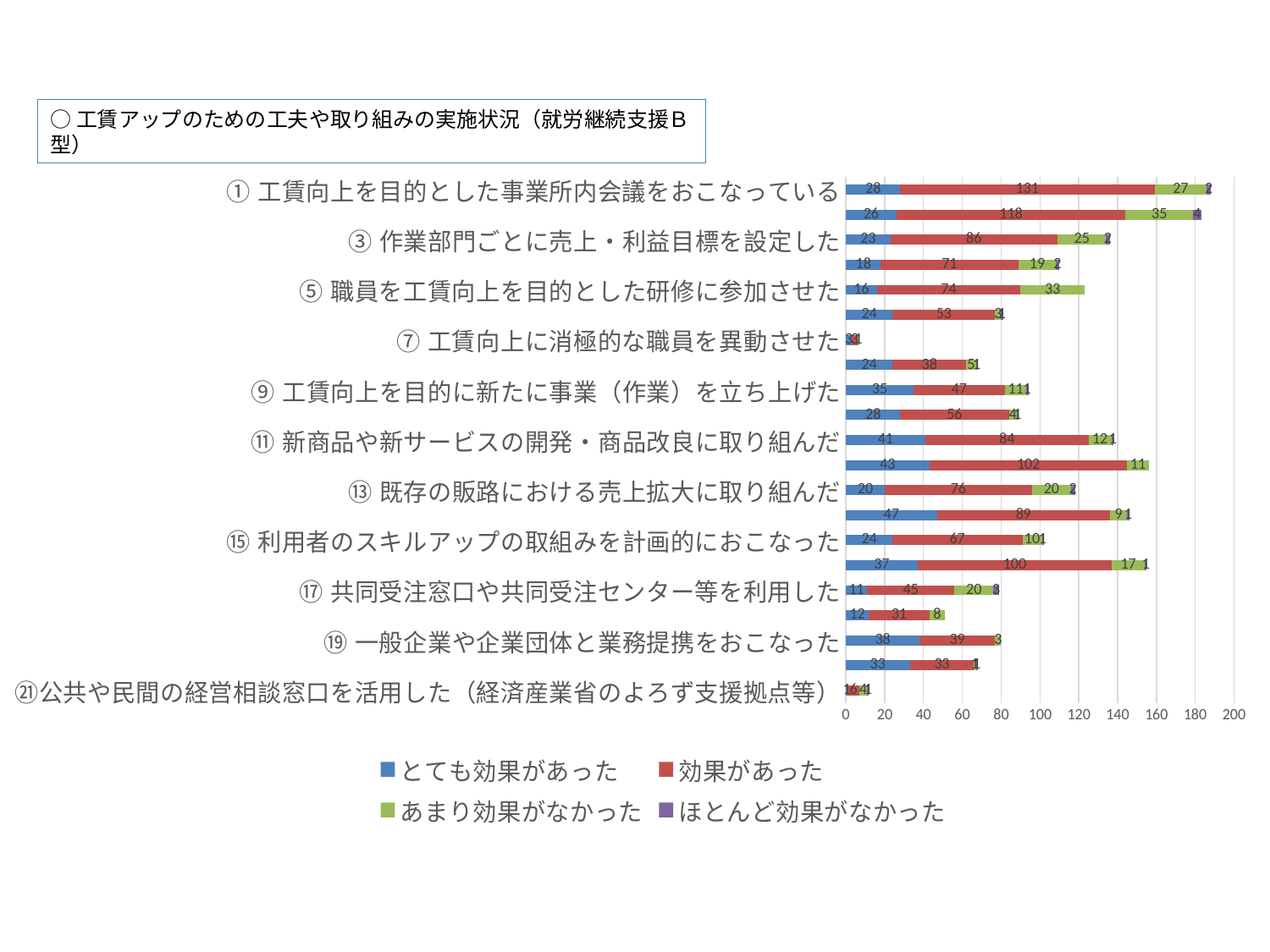
What is the value of とても効果があった for ⑤ 職員を工賃向上を目的とした研修に参加させた? 16 Which category has the highest value for 効果があった? ① 工賃向上を目的とした事業所内会議をおこなっている What kind of chart is shown on the slide? bar chart How many categories (bars) are plotted in the chart? 21 How many series does the legend list? 4 What is the value of あまり効果がなかった for ⑤ 職員を工賃向上を目的とした研修に参加させた? 33 What is the value of 効果があった for ⑤ 職員を工賃向上を目的とした研修に参加させた? 74 What is the value of 効果があった for ① 工賃向上を目的とした事業所内会議をおこなっている? 131 What is the value of 効果があった for ⑰ 共同受注窓口や共同受注センター等を利用した? 45 What is the value of とても効果があった for ⑲ 一般企業や企業団体と業務提携をおこなった? 38 Is the total length of the bar for ⑲ 一般企業や企業団体と業務提携をおこなった greater or less than 100? less For ⑤ 職員を工賃向上を目的とした研修に参加させた, what is the difference between 効果があった and とても効果があった? 58